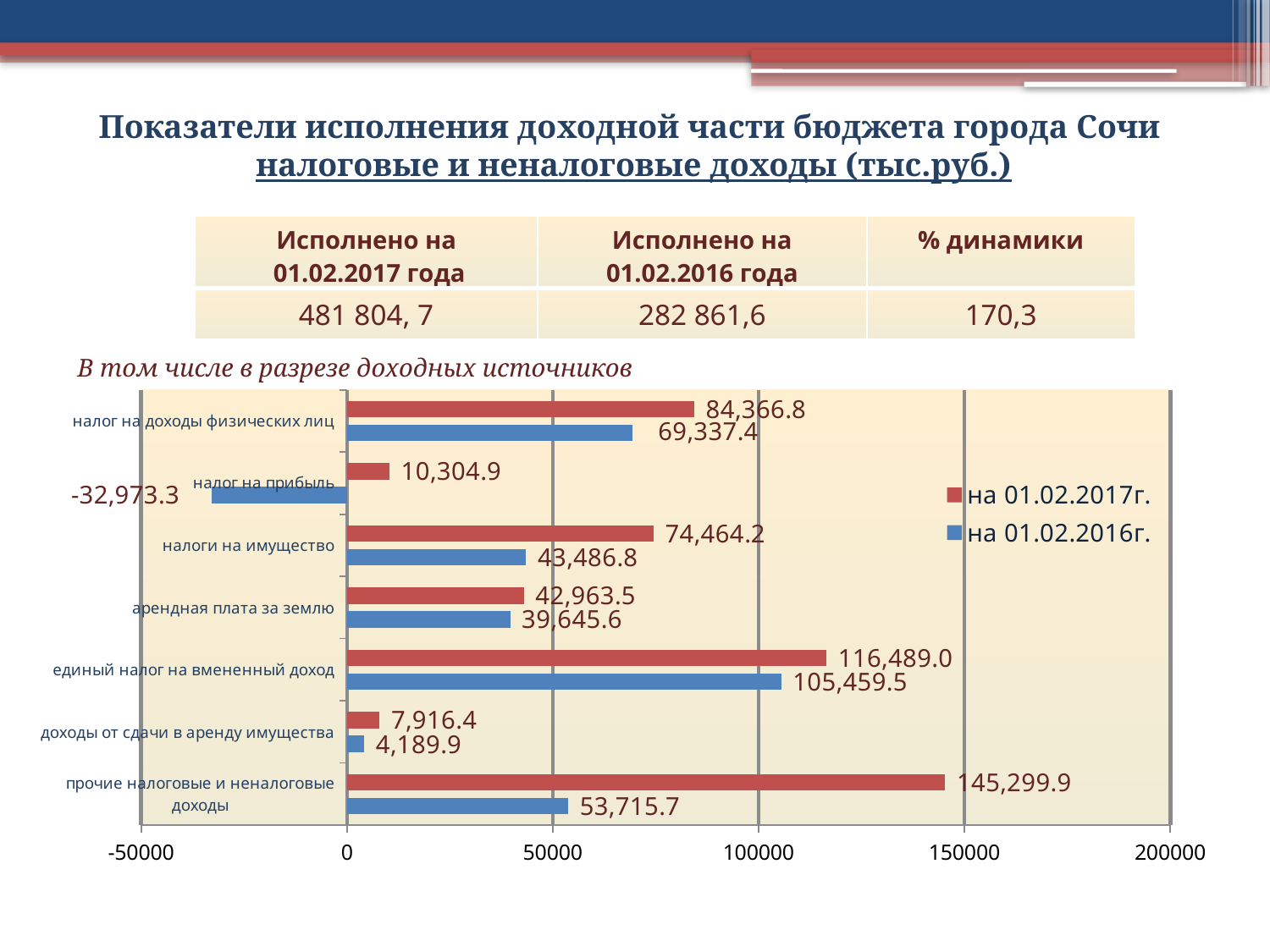
What is the value for "единый налог на вмененный доход" in the "на 01.02.2016г." series? 105,459.5 What is the value for "налог на доходы физических лиц" in the "на 01.02.2017г." series? 84,366.8 Which colour represents the "на 01.02.2016г." series? blue How many categories are shown on the chart? 7 Which is larger for "налоги на имущество": the "на 01.02.2017г." value or the "на 01.02.2016г." value? на 01.02.2017г. What is the value for "налог на прибыль" in the "на 01.02.2016г." series? -32,973.3 What is the difference between the "на 01.02.2017г." and "на 01.02.2016г." values for "прочие налоговые и неналоговые доходы"? 91,584.2 What is the difference between the "на 01.02.2017г." and "на 01.02.2016г." values for "налог на доходы физических лиц"? 15,029.4 What kind of chart is shown on the slide? bar chart Which category has the highest value in the "на 01.02.2017г." series? прочие налоговые и неналоговые доходы Which category has the lowest value in the "на 01.02.2016г." series? налог на прибыль How many series does the chart legend list? 2